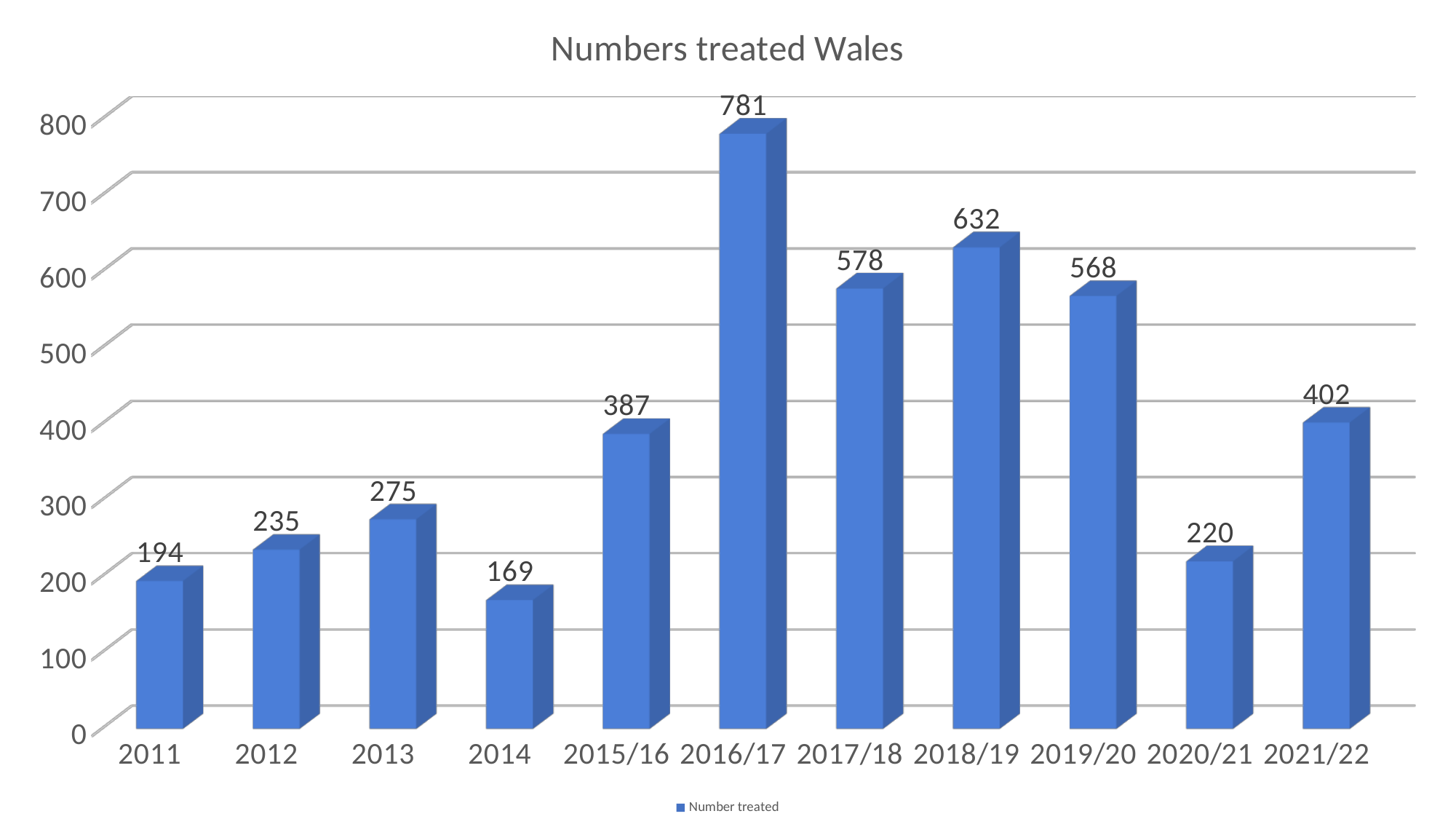
How many series does the legend list? 1 What is the title of the chart? Numbers treated Wales Which year has a larger number treated, 2017/18 or 2018/19? 2018/19 What kind of chart is shown on the slide? Bar chart Which year has the lowest number treated? 2014 How many years are shown on the x axis? 11 Is the value for 2015/16 greater or less than 300? greater What is the number treated in Wales for 2016/17? 781 What is the number treated in Wales for 2014? 169 Which year has the highest number treated? 2016/17 What is the number treated in Wales for 2021/22? 402 What is the difference between the number treated in 2018/19 and 2019/20? 64